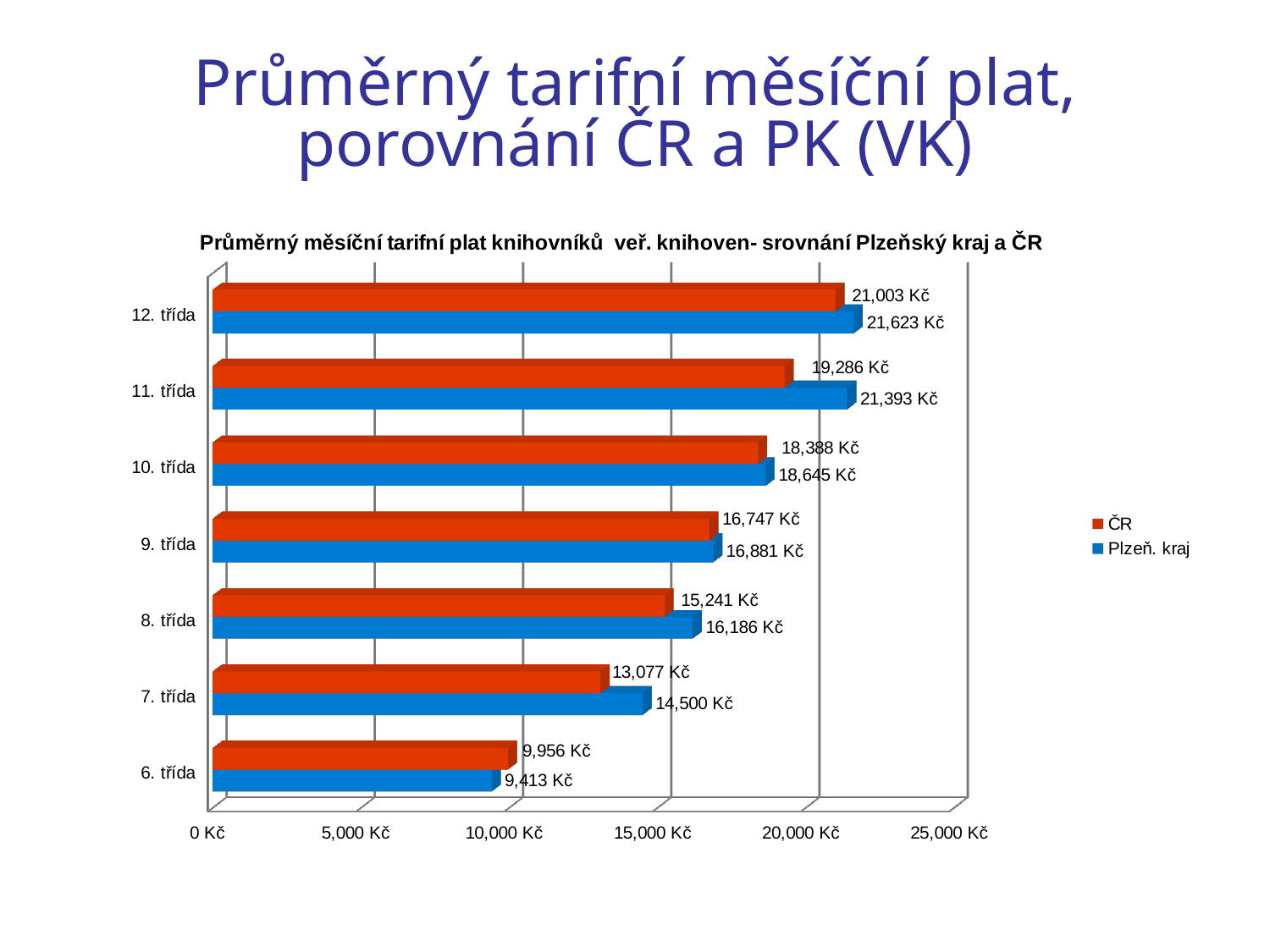
In 6. třída, which series has the larger value, ČR or Plzeň. kraj? ČR What is the value for Plzeň. kraj in 7. třída? 14,500 Kč What is the difference between the Plzeň. kraj and ČR values in 7. třída? 1,423 Kč Which category has the highest value for the Plzeň. kraj series? 12. třída What is the value for Plzeň. kraj in 9. třída? 16,881 Kč Is the value for Plzeň. kraj in 11. třída greater or less than 20,000 Kč? greater How many categories (třída) are shown on the chart? 7 What is the value for ČR in 12. třída? 21,003 Kč Which category has the lowest value for the ČR series? 6. třída How many series does the legend list? 2 What kind of chart is shown on the slide? bar chart What is the difference between the Plzeň. kraj and ČR values in 12. třída? 620 Kč